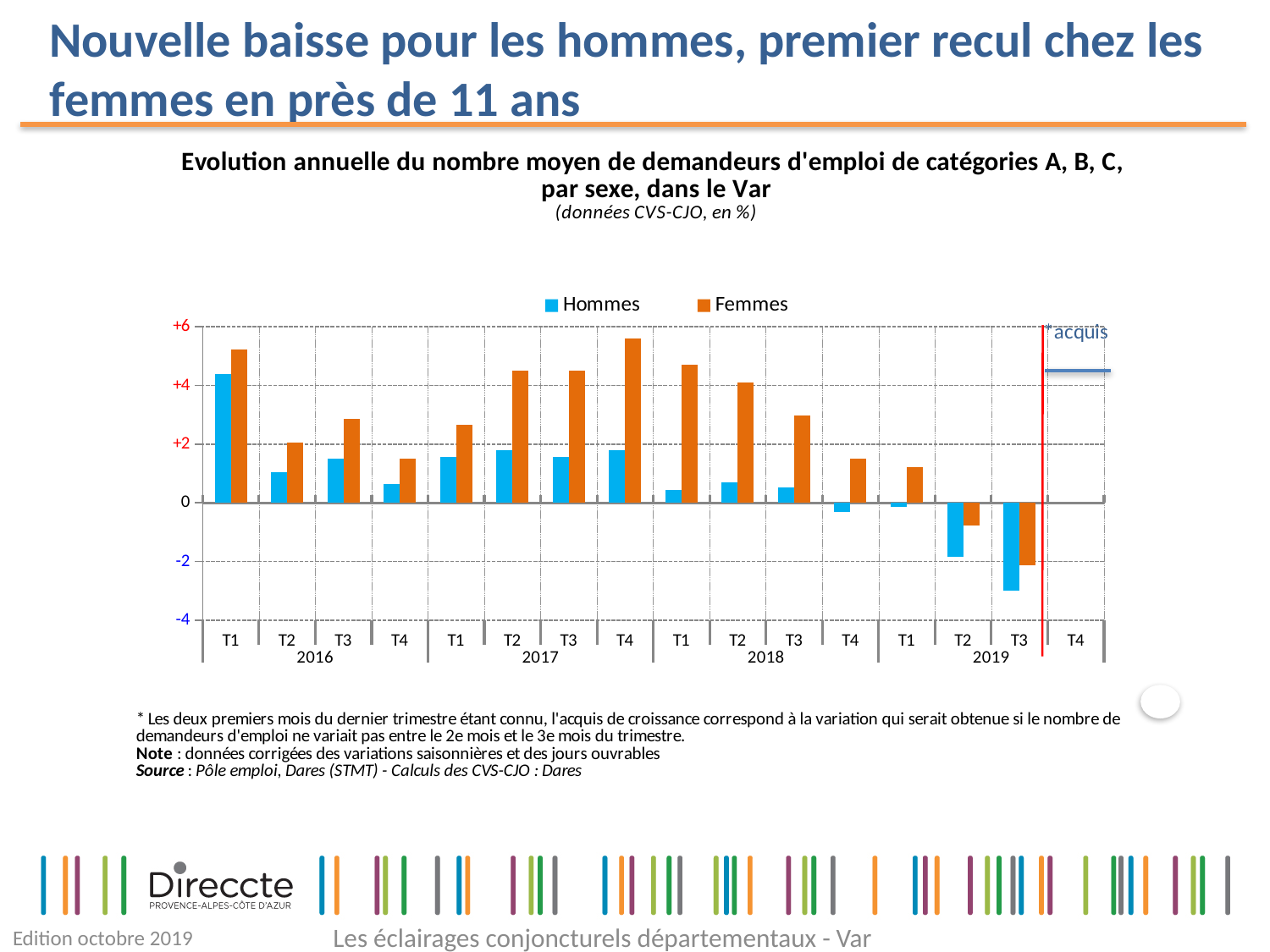
In which quarter is the value for Hommes the highest? T1 2016 In which quarter is the value for Femmes the lowest? T3 2019 Is the value for Hommes in T1 2016 greater or less than +4? greater Which series is shown in orange in the legend? Femmes Is the value for Femmes in T4 2017 greater or less than +4? greater What kind of chart is shown on the slide? bar chart From T1 2018 to T3 2019, do the values for Femmes rise or fall? fall In T1 2018, which series has the larger value, Hommes or Femmes? Femmes How many series does the legend list? 2 How many years are labelled along the x axis? 4 Is the value for Hommes in T3 2019 greater or less than -2? less In which quarter is the value for Hommes the lowest? T3 2019